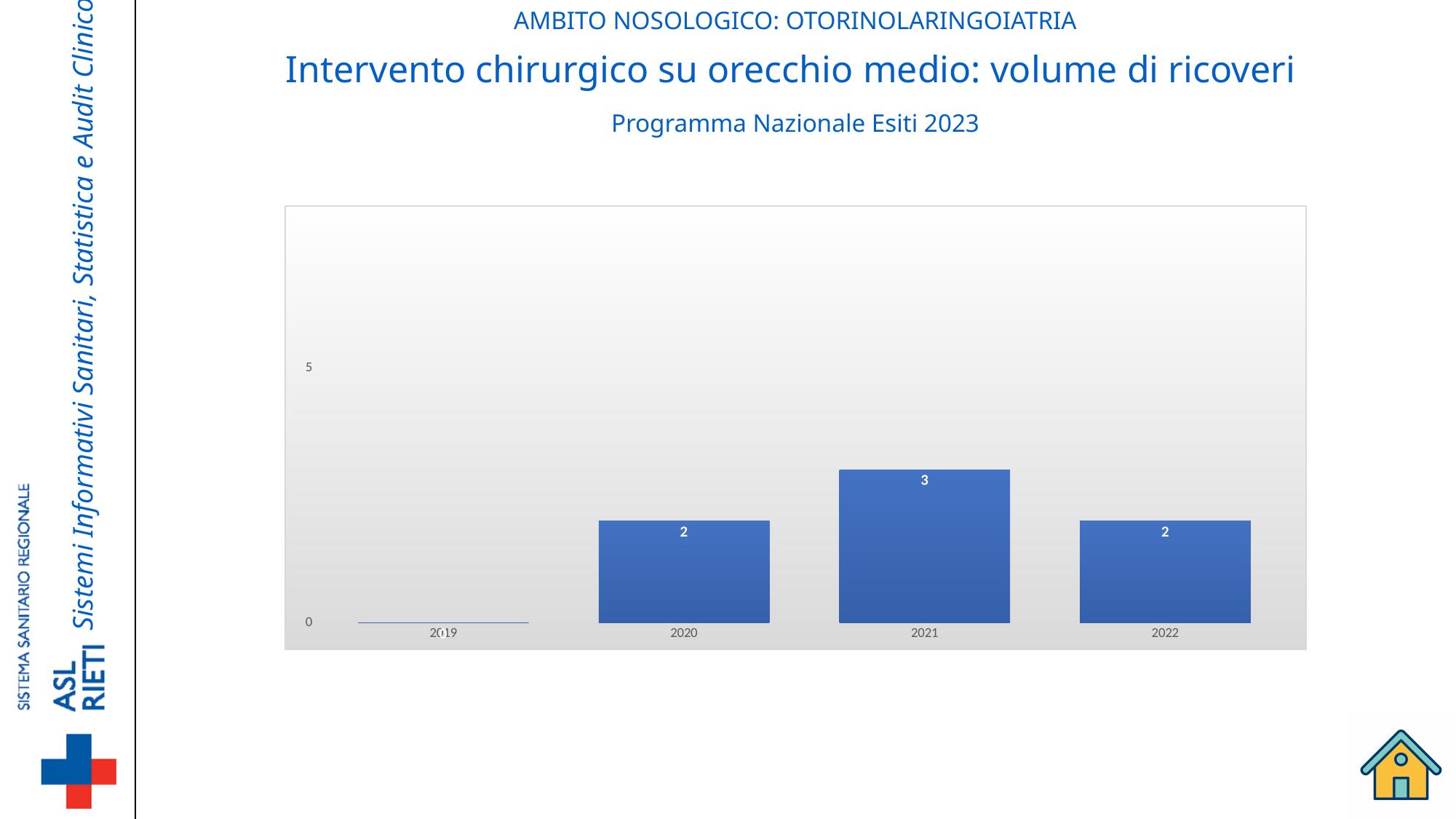
What is the difference between the values for 2021 and 2020? 1 What is the value for 2020? 2 What is the value for 2021? 3 What is the value for 2019? 0 Which year has the lowest value? 2019 What is the value for 2022? 2 Is the value for 2021 greater or less than 5? less What kind of chart is shown on the slide? bar chart Does the value rise or fall from 2021 to 2022? fall How many years are shown on the x axis? 4 Which year has the highest value? 2021 Which is larger, the value for 2021 or the value for 2022? 2021